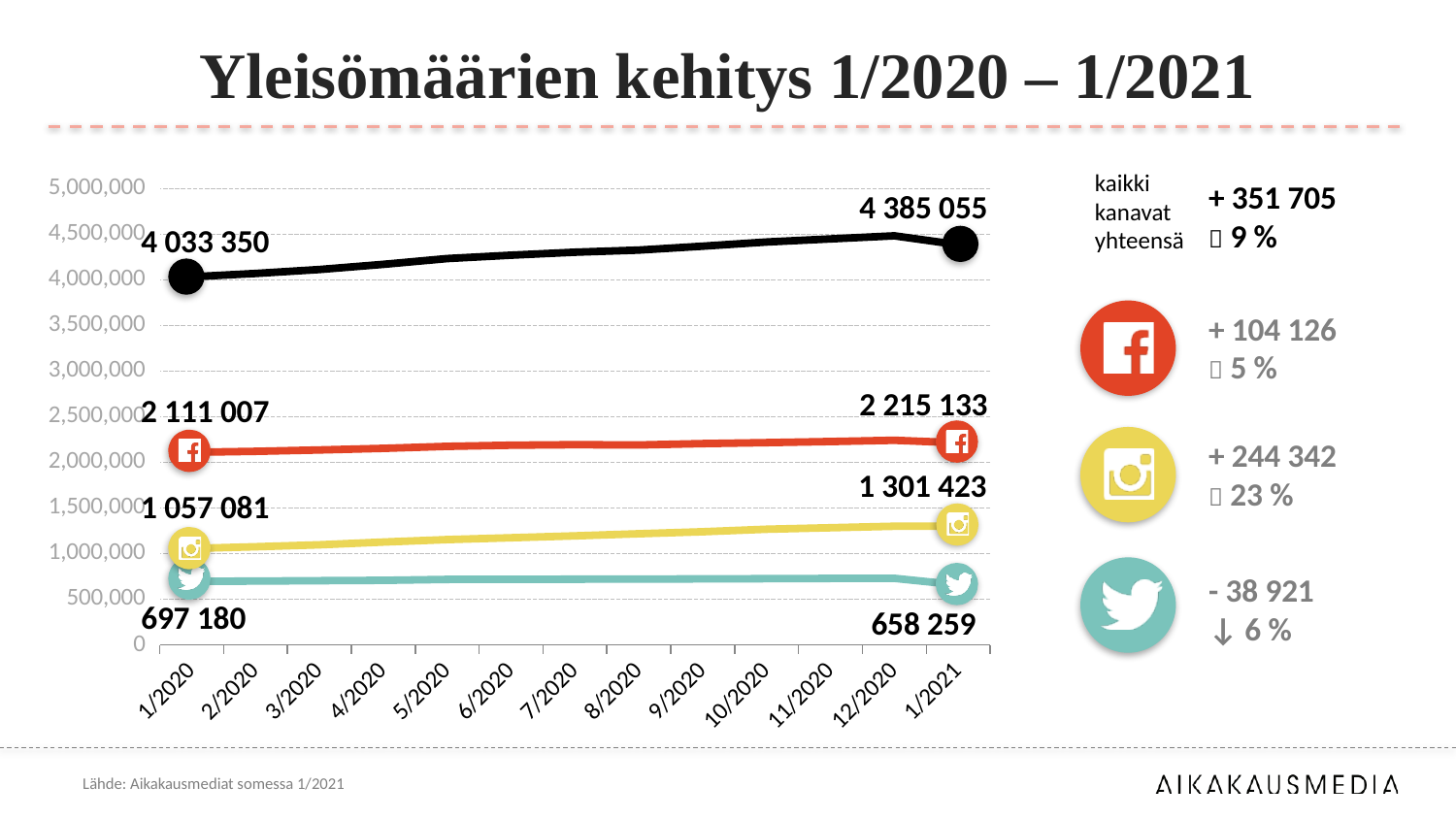
Is the value of the black (total) line at 6/2020 greater or less than 4,000,000? greater How many time points are shown on the x axis? 13 What is the title of the chart? Yleisömäärien kehitys 1/2020 – 1/2021 Which platform has the lowest value at 1/2021? Twitter What kind of chart is shown on the slide? line chart By how much did the Instagram value change from 1/2020 to 1/2021? + 244 342 What is the value of the black (total) line at 1/2021? 4 385 055 Does the Twitter line rise or fall from 1/2020 to 1/2021? falls At 1/2021, which is larger: the Facebook value or the Instagram value? Facebook What is the Instagram value at 1/2021? 1 301 423 What is the Twitter value at 1/2020? 697 180 What is the Facebook value at 1/2020? 2 111 007